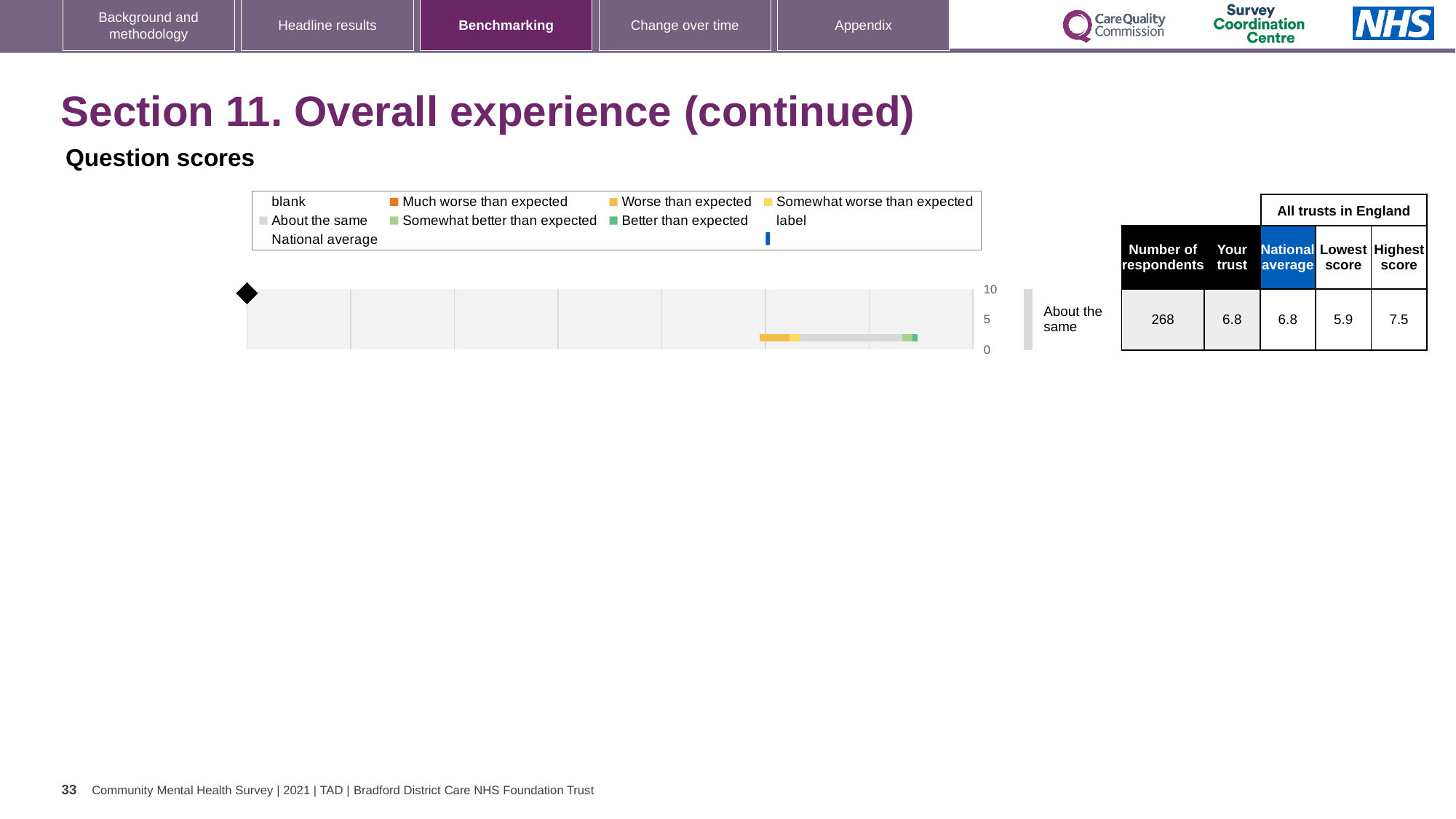
What is the Highest score among all trusts in England for the 'About the same' row? 7.5 How many respondents are listed for the 'About the same' row? 268 What is the Lowest score among all trusts in England for the 'About the same' row? 5.9 By how much does the 'Your trust' score exceed the Lowest score for the 'About the same' row? 0.9 What is the 'Your trust' score for the 'About the same' row? 6.8 What is the label of the single row plotted in the chart? About the same Is the 'Your trust' score higher than, lower than, or equal to the National average for the 'About the same' row? equal What kind of chart is shown under 'Question scores'? bar chart What is the difference between the Highest score and the Lowest score for the 'About the same' row? 1.6 How many question rows are plotted in the chart? 1 What is the highest value shown on the chart's score axis? 10 What is the National average score for the 'About the same' row? 6.8